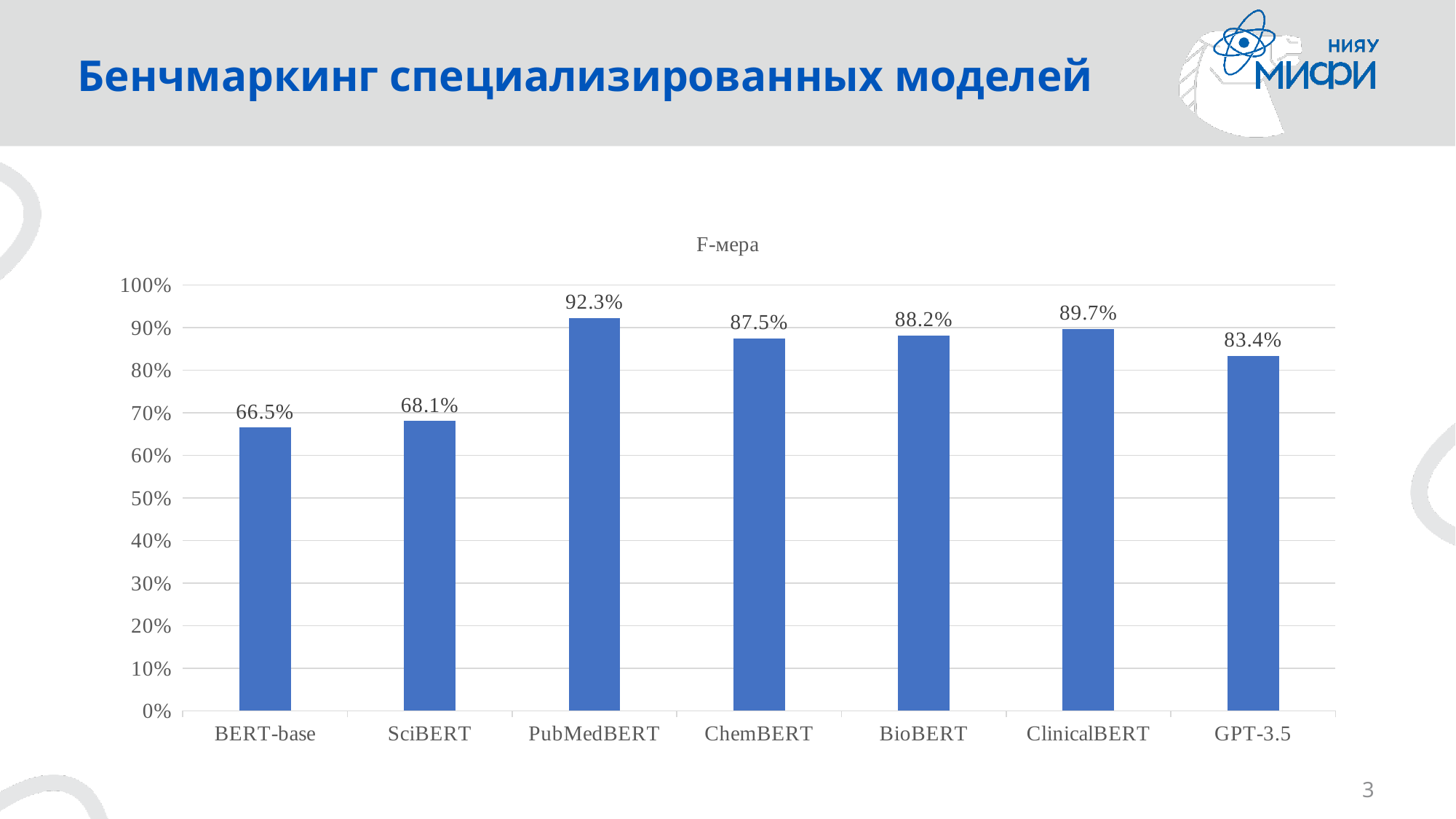
What is the F-мера value for GPT-3.5? 83.4% What is the difference between the F-мера of PubMedBERT and BERT-base? 25.8% Is the F-мера value for SciBERT greater or less than 70%? less Which model has the highest F-мера? PubMedBERT What is the F-мера value for PubMedBERT? 92.3% Which has a higher F-мера, BioBERT or GPT-3.5? BioBERT Which model has the lowest F-мера? BERT-base What is the difference between the F-мера of ClinicalBERT and ChemBERT? 2.2% What is the F-мера value for BERT-base? 66.5% How many models are shown in the chart? 7 What is the title of the chart? F-мера What kind of chart is shown on the slide? bar chart